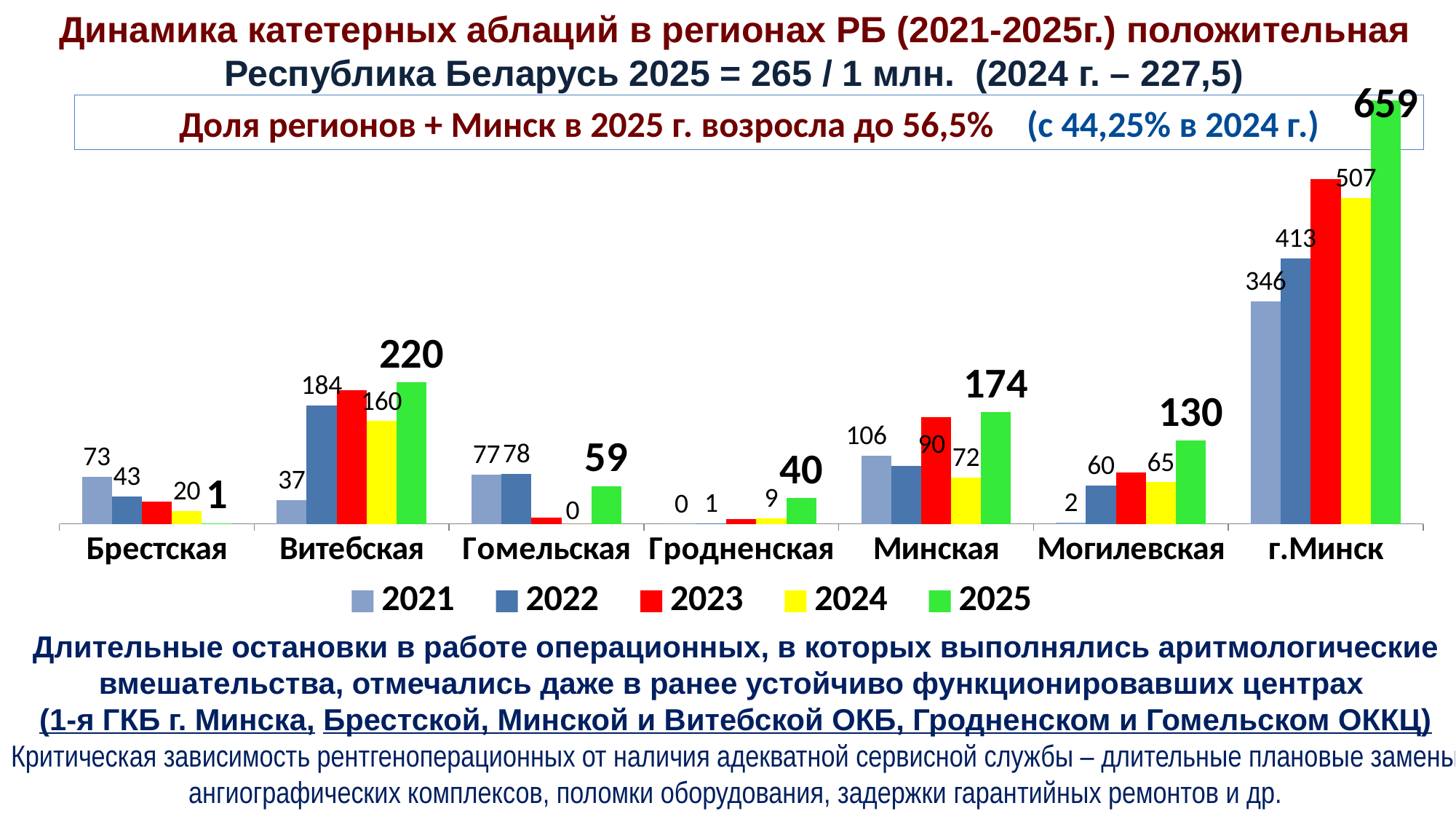
What is the value for Брестская in 2021? 73 What is the value for г.Минск in 2025? 659 Which is larger: the 2025 value for Минская or the 2025 value for Могилевская? Минская Which region has the lowest value in 2025? Брестская What kind of chart is this? bar chart Which colour represents the 2025 series in the legend? green What is the difference between the 2025 values for г.Минск and Витебская? 439 How many series does the legend list? 5 How many regions are shown on the x axis? 7 Which region has the highest value in 2025? г.Минск What is the value for Витебская in 2022? 184 What is the value for Могилевская in 2025? 130